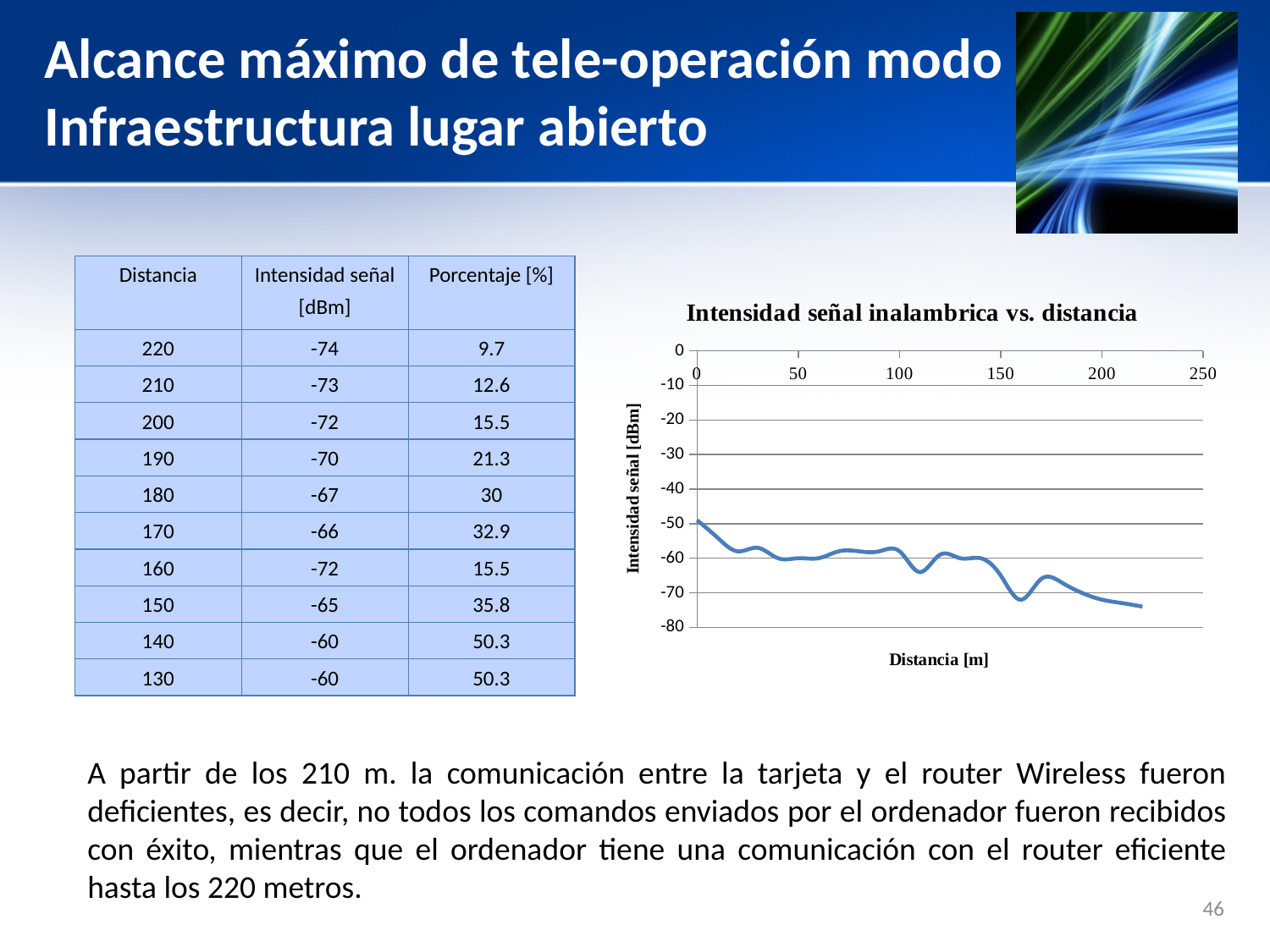
What kind of chart is shown on the slide? line chart Overall, does the signal intensity rise or fall as distance increases along the x axis? fall Is the signal intensity at a distance of 0 m greater or less than -60 dBm? greater Is the signal intensity at a distance of 160 m greater or less than -60 dBm? less What is the label of the y axis of the chart? Intensidad señal [dBm] Which has the higher signal intensity on the chart: the point at 0 m or the point at 220 m? 0 m Is the signal intensity at a distance of 0 m greater or less than -40 dBm? less What is the largest value shown on the x axis of the chart? 250 What is the title of the chart? Intensidad señal inalambrica vs. distancia